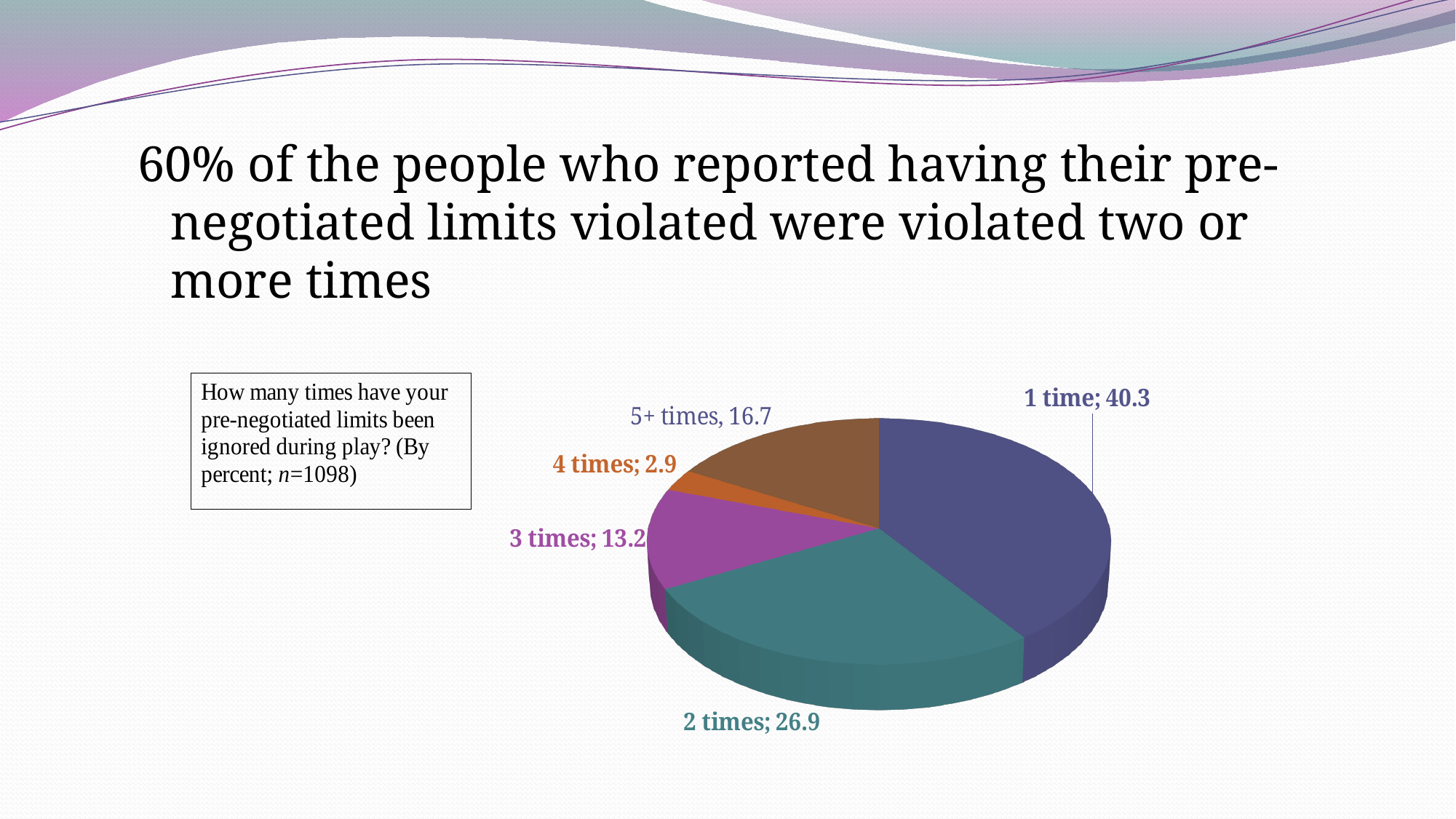
What is the value for the "1 time" slice? 40.3 Which is larger, the "3 times" slice or the "5+ times" slice? 5+ times What is the value for the "3 times" slice? 13.2 What is the difference between the "1 time" and "2 times" values? 13.4 What is the sample size (n) stated in the text box next to the chart? 1098 What is the value for the "2 times" slice? 26.9 How many slices does the pie chart have? 5 What kind of chart is shown on the slide? pie chart What is the value for the "4 times" slice? 2.9 Which category has the smallest slice? 4 times Which category has the largest slice? 1 time What is the value for the "5+ times" slice? 16.7